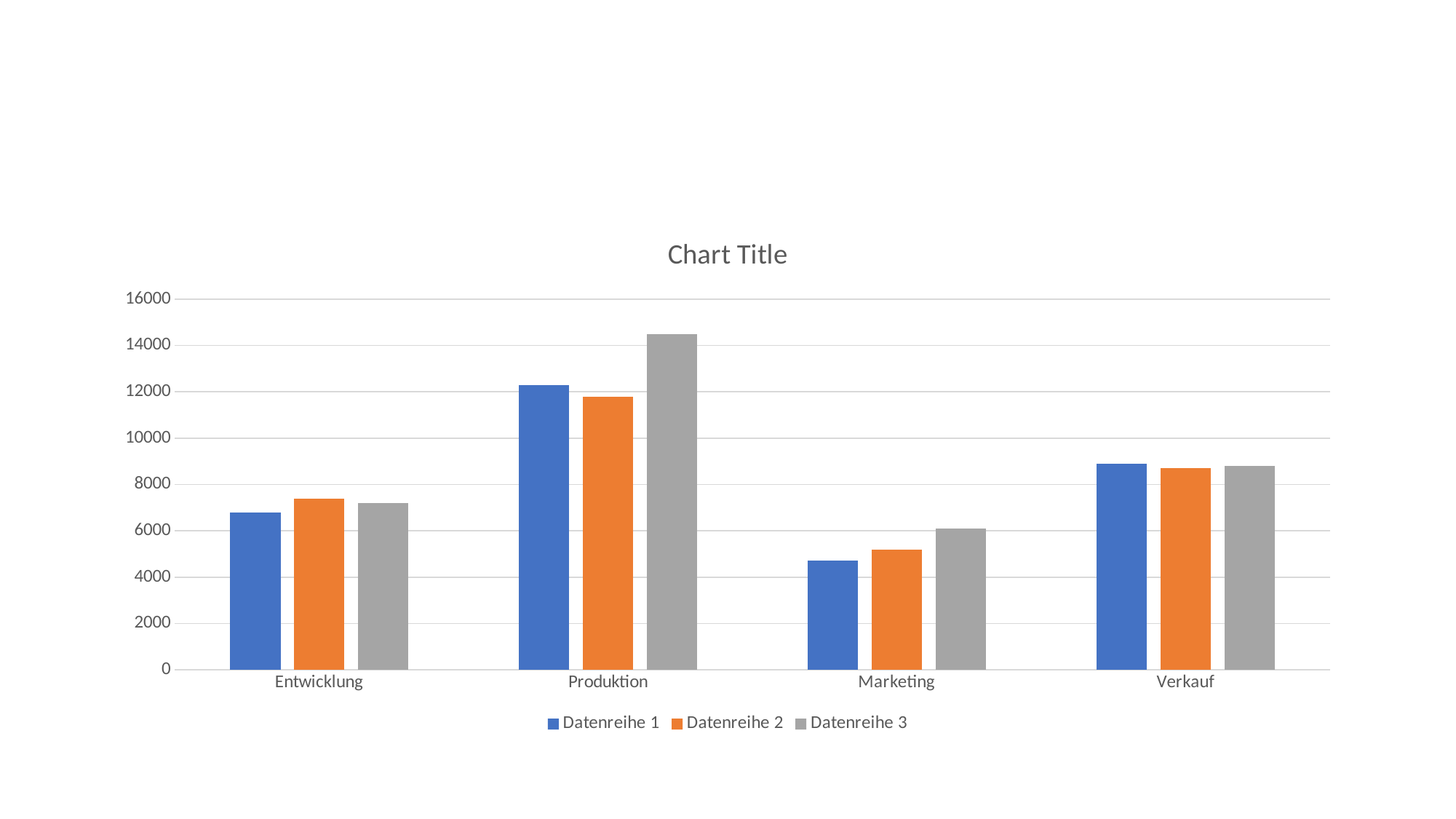
Is the value for Datenreihe 1 in Marketing greater or less than 6000? less Is the value for Datenreihe 3 in Produktion greater or less than 14000? greater In Marketing, which is larger: Datenreihe 1 or Datenreihe 3? Datenreihe 3 In Produktion, which is larger: Datenreihe 1 or Datenreihe 3? Datenreihe 3 What is the title of the chart? Chart Title What kind of chart is shown on the slide? bar chart Which category has the highest value for Datenreihe 3? Produktion Is the value for Datenreihe 2 in Produktion greater or less than 10000? greater How many categories are shown on the x axis? 4 How many series does the legend list? 3 Which category has the lowest value for Datenreihe 1? Marketing